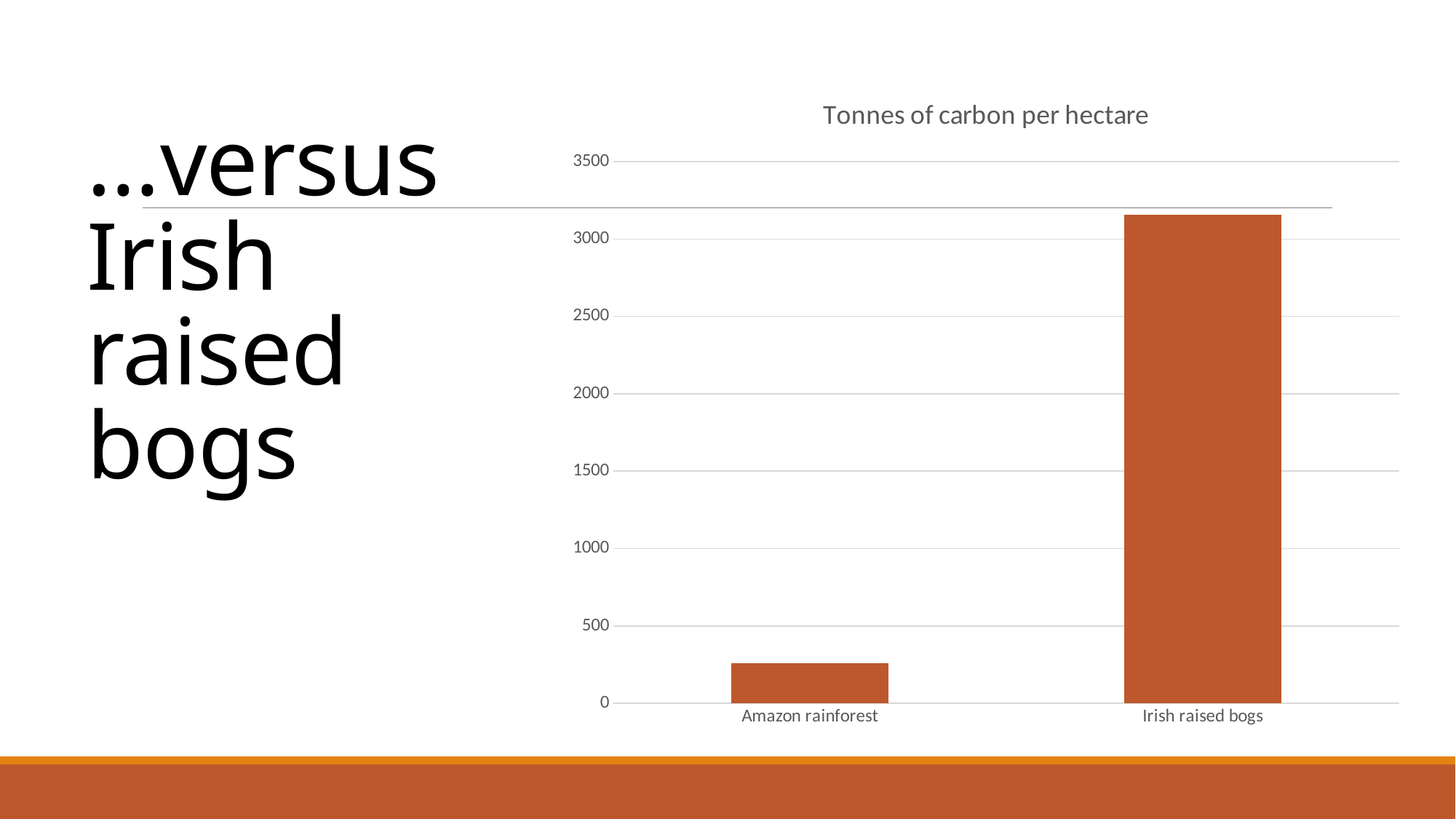
Is the value for Irish raised bogs greater or less than 3500? less What is the highest value shown on the vertical axis of the chart? 3500 What is the title of the chart? Tonnes of carbon per hectare How many categories are shown on the x axis of the chart? 2 Which is larger, the value for Amazon rainforest or the value for Irish raised bogs? Irish raised bogs Which category has the lowest value in the chart? Amazon rainforest What kind of chart is shown on the slide? bar chart Do the values rise or fall from Amazon rainforest to Irish raised bogs along the x axis? rise Is the value for Irish raised bogs greater or less than 3000? greater Is the value for Amazon rainforest greater or less than 500? less Which category has the highest value in the chart? Irish raised bogs